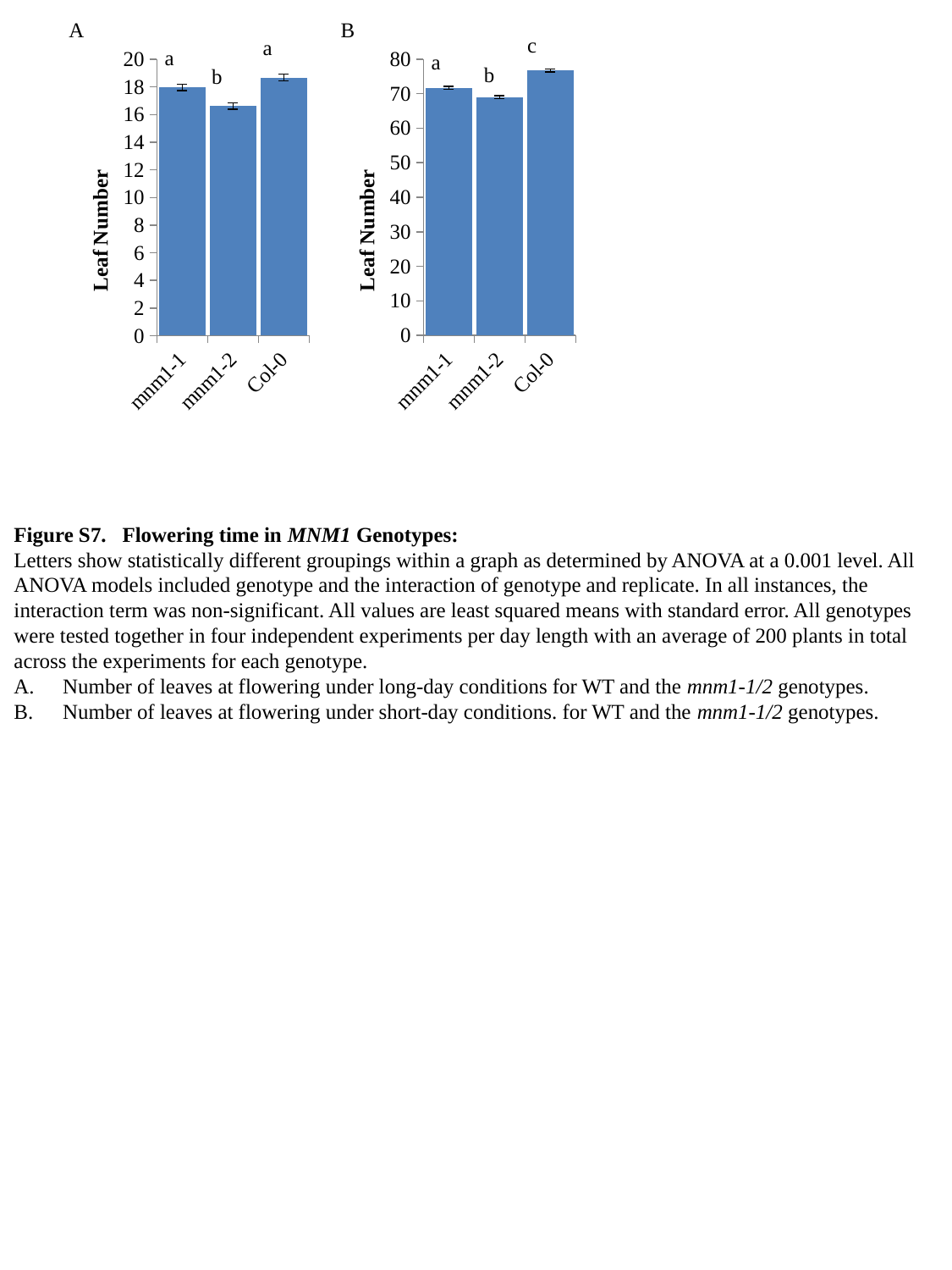
In chart B, what statistical grouping letter is shown above the Col-0 bar? c In chart B, which genotype has the lowest leaf number? mnm1-2 In chart B, is the value for Col-0 greater or less than 70? greater In chart A, is the value for mnm1-2 greater or less than 18? less In chart B, which genotype has the highest leaf number? Col-0 In chart B, is the value for mnm1-2 greater or less than 70? less How many genotypes (bars) are shown in chart B? 3 In chart A, which is larger, the value for mnm1-1 or the value for mnm1-2? mnm1-1 What is the y-axis label of chart B? Leaf Number In chart A, which genotype has the lowest leaf number? mnm1-2 What kind of chart is chart A? bar chart